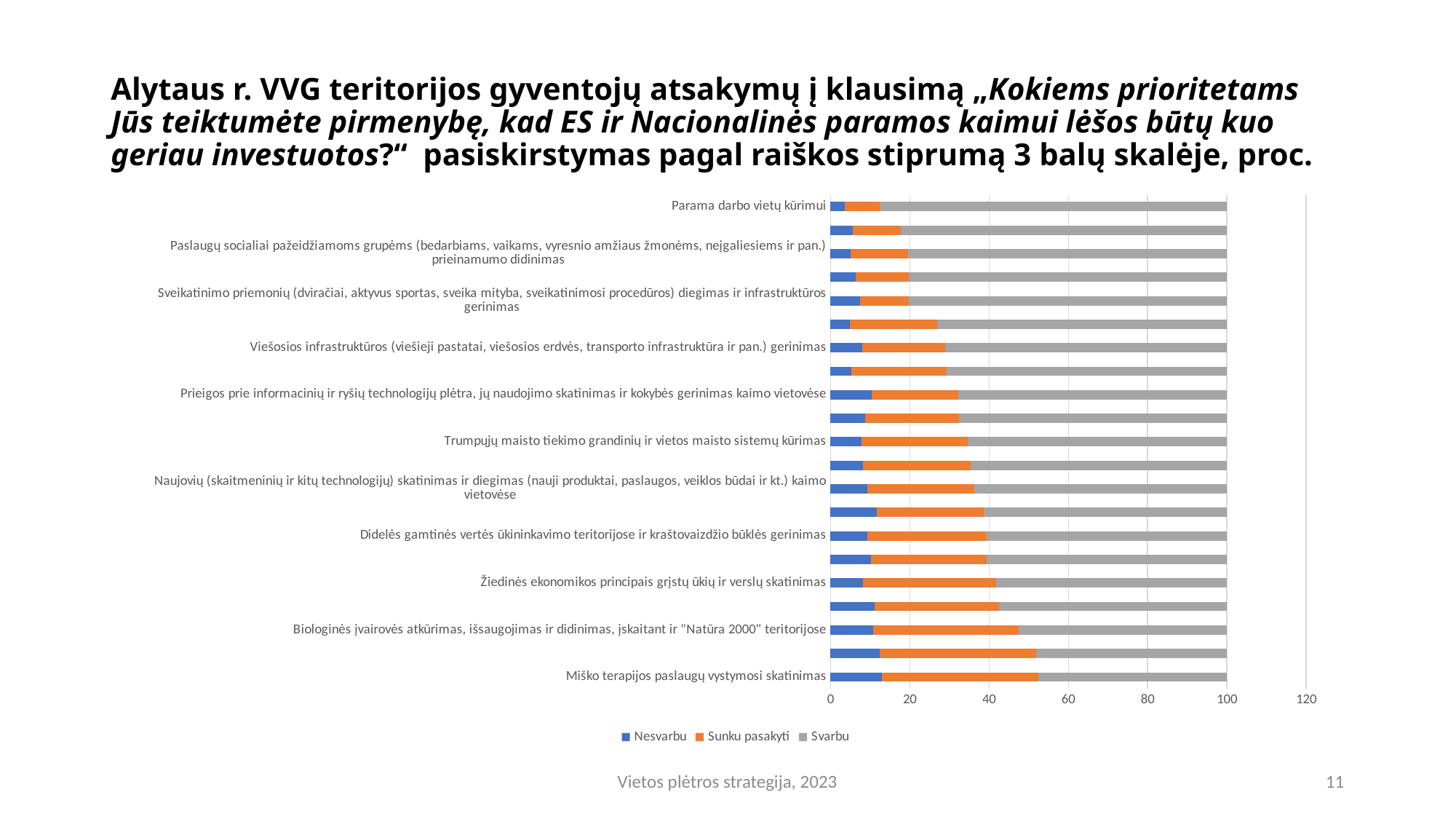
Which has the larger 'Nesvarbu' value: 'Parama darbo vietų kūrimui' or 'Miško terapijos paslaugų vystymosi skatinimas'? Miško terapijos paslaugų vystymosi skatinimas What is the total of the stacked bar for 'Parama darbo vietų kūrimui'? 100 What kind of chart is shown on the slide? Stacked horizontal bar chart Is the 'Nesvarbu' value for 'Parama darbo vietų kūrimui' greater or less than 20? less Does the 'Svarbu' share rise or fall moving from the top bar to the bottom bar of the chart? Fall Is the 'Nesvarbu' value for 'Miško terapijos paslaugų vystymosi skatinimas' greater or less than 20? less Is the 'Svarbu' value for 'Miško terapijos paslaugų vystymosi skatinimas' greater or less than 60? less How many series does the legend list? 3 Which has the larger 'Svarbu' value: 'Parama darbo vietų kūrimui' or 'Miško terapijos paslaugų vystymosi skatinimas'? Parama darbo vietų kūrimui What are the three series named in the legend? Nesvarbu, Sunku pasakyti, Svarbu Which colour represents the 'Svarbu' series? Grey